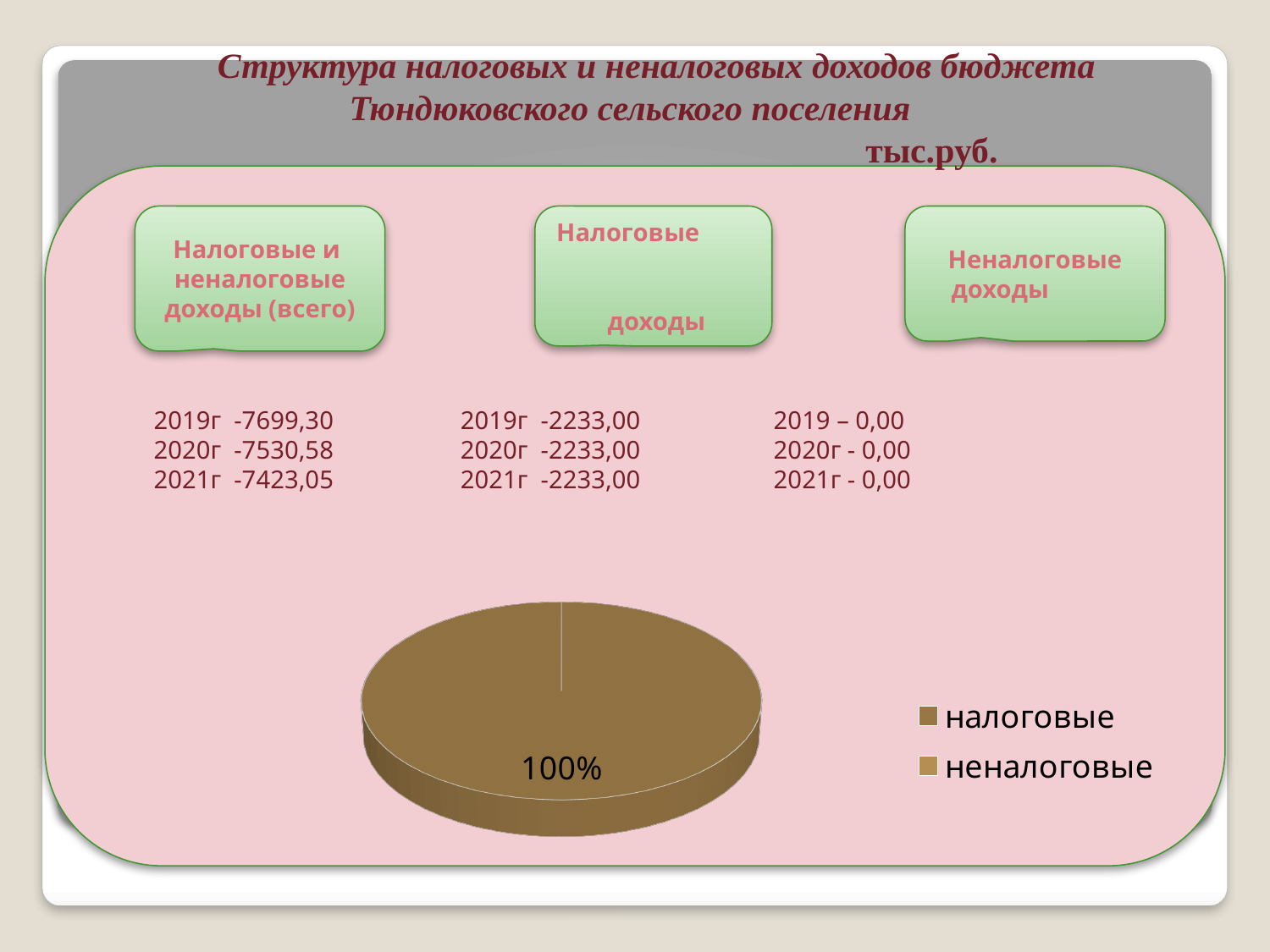
How many entries does the legend of the pie chart list? 2 How many slices are visibly drawn on the pie chart? 1 Which category takes up the whole pie chart? налоговые What percentage label is printed on the pie chart? 100% What are the two entries listed in the pie chart's legend? налоговые, неналоговые What share of the pie does the налоговые category have? 100% Which legend entry is listed first in the pie chart's legend? налоговые What kind of chart is shown at the bottom of the slide? pie chart